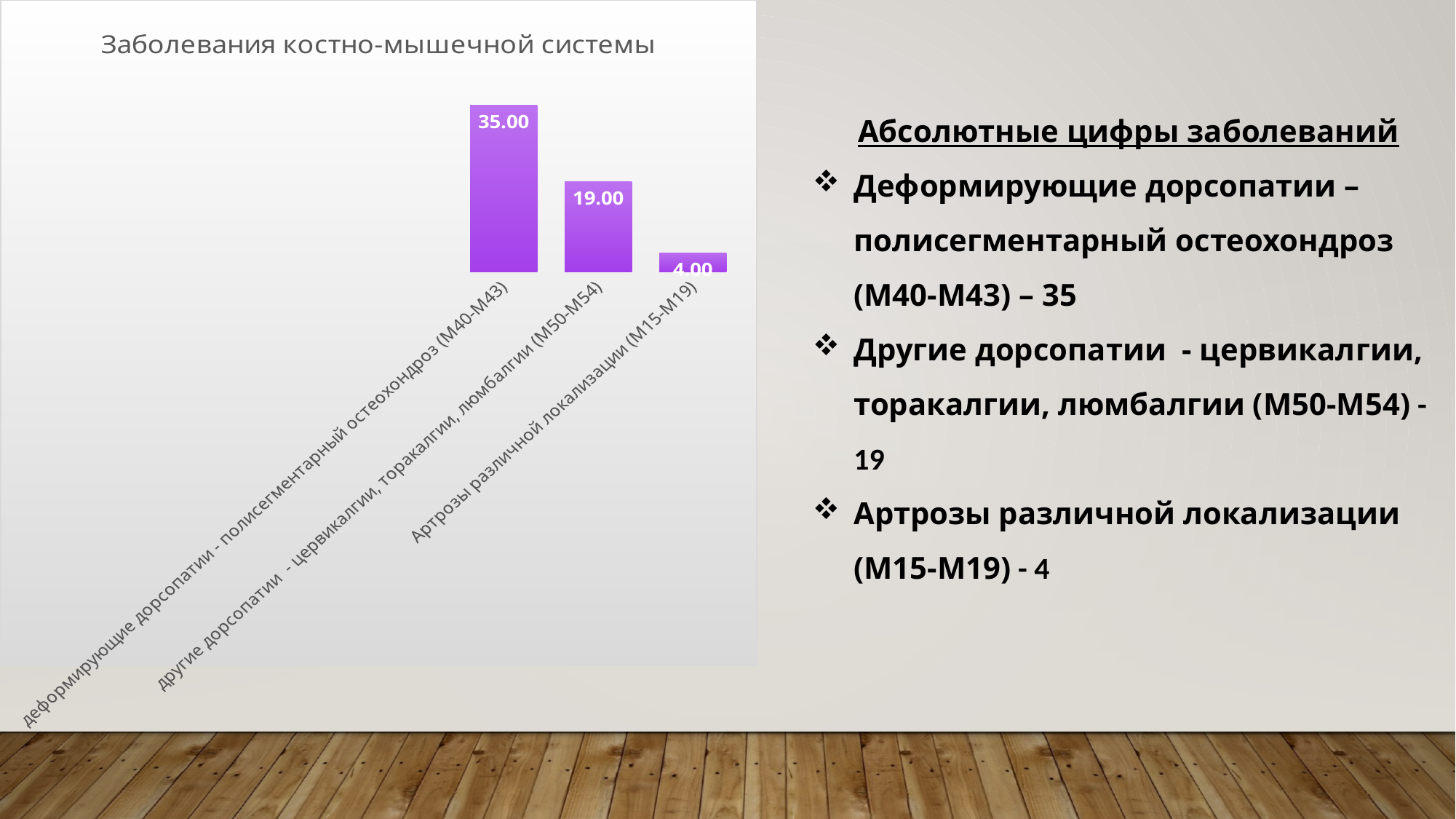
Do the values rise or fall from left to right along the x axis? fall Which is larger: the value for другие дорсопатии (М50-М54) or the value for Артрозы различной локализации (М15-М19)? другие дорсопатии (М50-М54) How many categories are shown in the chart? 3 What is the difference between the values for деформирующие дорсопатии (М40-М43) and другие дорсопатии (М50-М54)? 16.00 What is the value for Артрозы различной локализации (М15-М19)? 4.00 Which category has the highest value? деформирующие дорсопатии - полисегментарный остеохондроз (М40-М43) What is the difference between the values for другие дорсопатии (М50-М54) and Артрозы различной локализации (М15-М19)? 15.00 What is the value for деформирующие дорсопатии - полисегментарный остеохондроз (М40-М43)? 35.00 Which category has the lowest value? Артрозы различной локализации (М15-М19) What is the title of the chart? Заболевания костно-мышечной системы What is the value for другие дорсопатии - цервикалгии, торакалгии, люмбалгии (М50-М54)? 19.00 What kind of chart is shown on the slide? bar chart